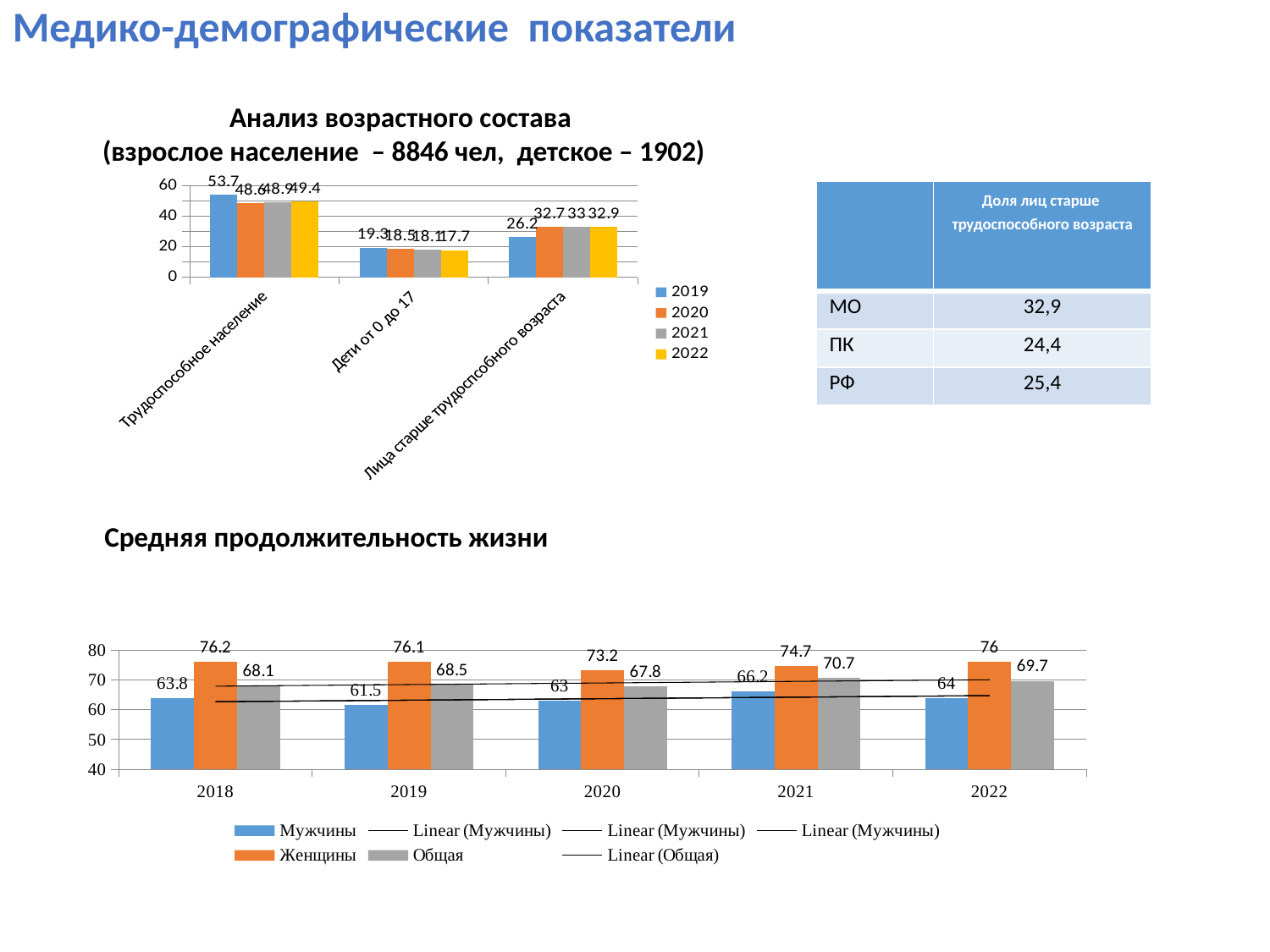
In the chart 'Средняя продолжительность жизни', is the value for Общая in 2020 greater or less than 70? less In the chart 'Анализ возрастного состава', which category has the lowest values across all years? Дети от 0 до 17 In the chart 'Средняя продолжительность жизни', which year has the highest value for Мужчины? 2021 In the chart 'Средняя продолжительность жизни', what is the value for Мужчины in 2019? 61.5 In the chart 'Средняя продолжительность жизни', what is the value for Женщины in 2018? 76.2 In the chart 'Средняя продолжительность жизни', how many years are shown on the x axis? 5 In the chart 'Средняя продолжительность жизни', which year has the lowest value for Женщины? 2020 In the chart 'Анализ возрастного состава', how many series does the legend list? 4 In the chart 'Анализ возрастного состава', what is the value for Трудоспособное население in 2019? 53.7 In the chart 'Средняя продолжительность жизни', what is the value for Общая in 2021? 70.7 In the chart 'Анализ возрастного состава', what is the value for Лица старше трудоспособного возраста in 2020? 32.7 In the chart 'Средняя продолжительность жизни', what is the difference between the Женщины and Мужчины values in 2022? 12